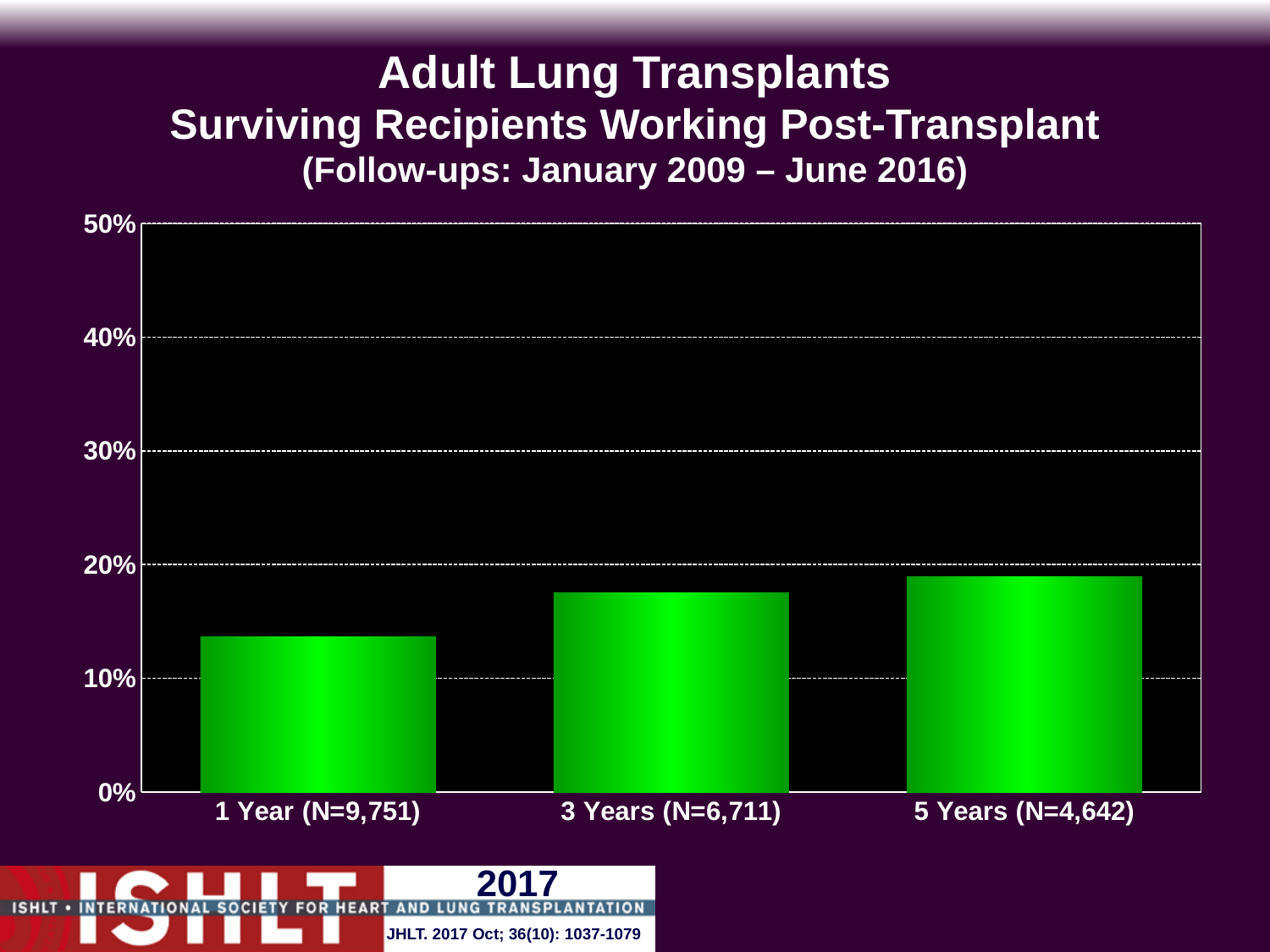
How many categories (follow-up time points) are shown on the x axis? 3 Which is larger, the value for 1 Year (N=9,751) or the value for 3 Years (N=6,711)? 3 Years (N=6,711) What kind of chart is shown on the slide? Bar chart Is the value for 5 Years (N=4,642) greater or less than 10%? greater Which follow-up time point has the highest percentage of surviving recipients working? 5 Years (N=4,642) Is the value for 5 Years (N=4,642) greater or less than 20%? less Do the values rise or fall from 1 Year to 5 Years along the x axis? rise What follow-up period is given in the chart title? January 2009 – June 2016 Is the value for 1 Year (N=9,751) greater or less than 10%? greater Which follow-up time point has the lowest percentage of surviving recipients working? 1 Year (N=9,751)